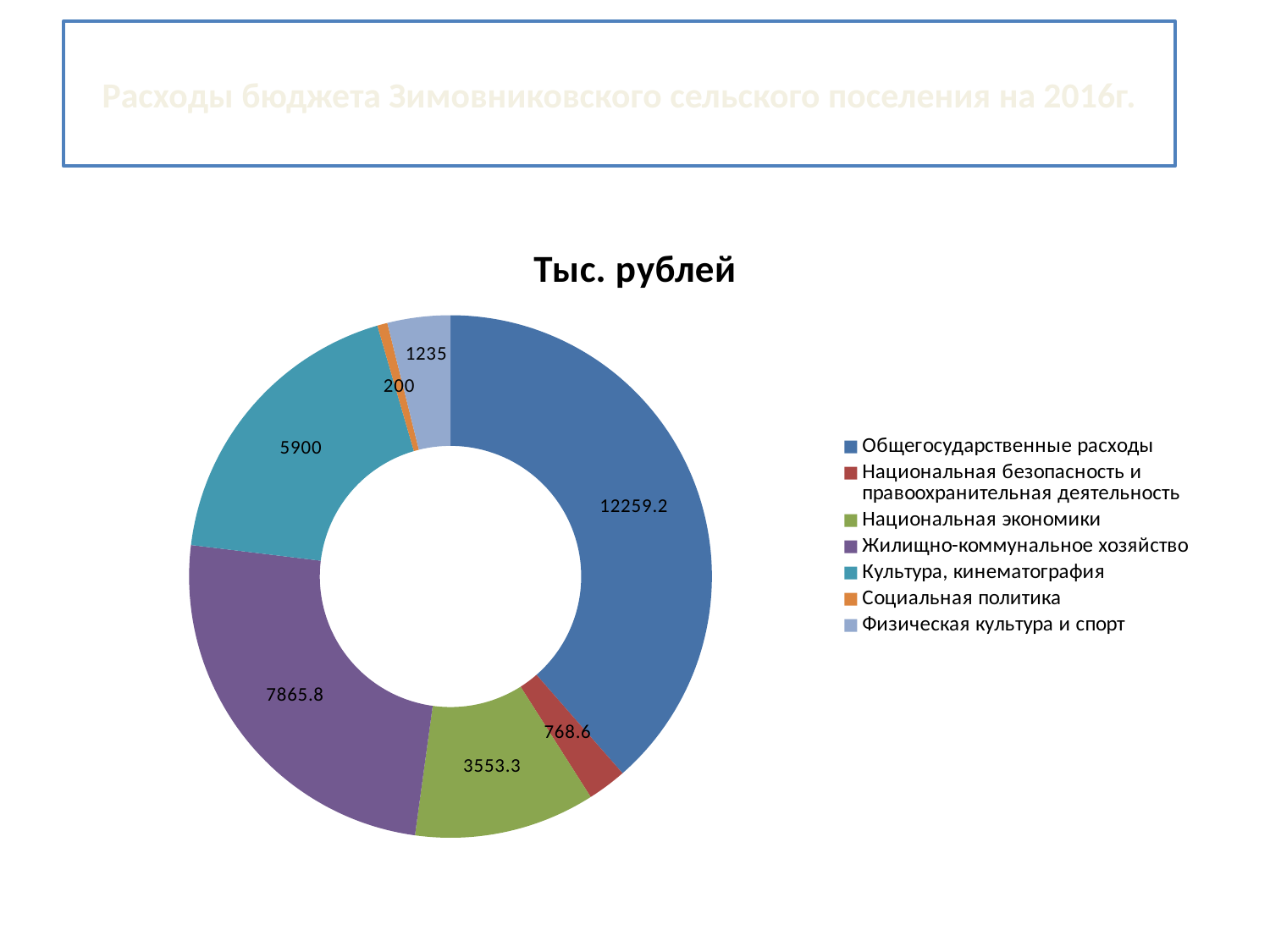
What is the value for Общегосударственные расходы? 12259.2 Which category has the largest value? Общегосударственные расходы What is the value for Жилищно-коммунальное хозяйство? 7865.8 What is the value for Культура, кинематография? 5900 Which category has the smallest value? Социальная политика How many categories does the chart show? 7 What is the value for Физическая культура и спорт? 1235 What is the difference between Культура, кинематография and Национальная экономики? 2346.7 What is the value for Социальная политика? 200 What is the difference between Общегосударственные расходы and Жилищно-коммунальное хозяйство? 4393.4 What is the title of the chart? Тыс. рублей Which is larger: Национальная экономики or Национальная безопасность и правоохранительная деятельность? Национальная экономики